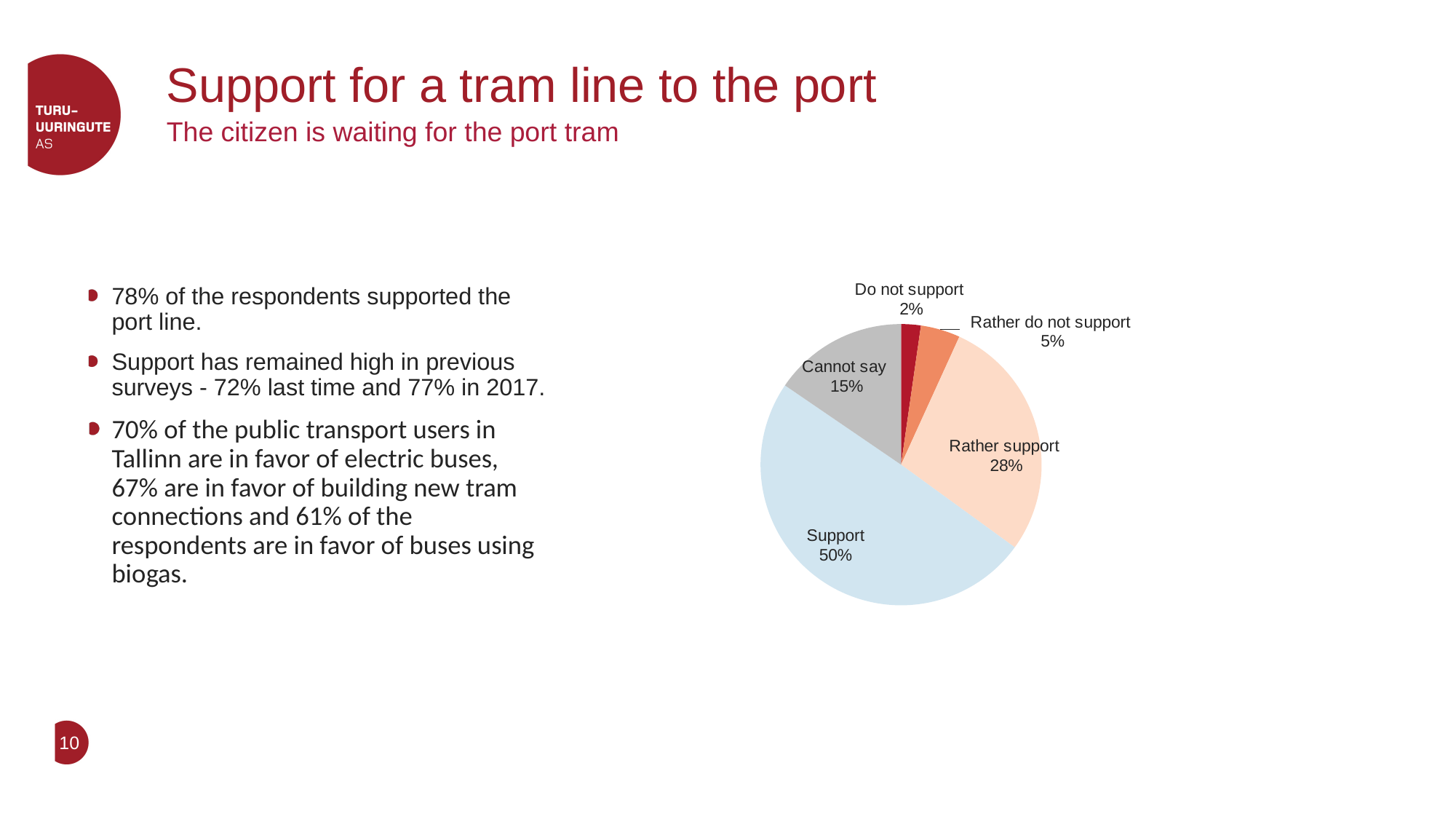
What is the value for "Rather do not support"? 5% Which category has the smallest slice of the pie? Do not support What is the value for "Rather support"? 28% What kind of chart is shown on the slide? pie chart What share of the pie does the "Support" slice represent? 50% Which category has the largest slice of the pie? Support What is the value for "Do not support"? 2% Which is larger, "Cannot say" or "Rather do not support"? Cannot say How many slices does the pie chart have? 5 What is the value for "Cannot say"? 15% What is the difference between the "Support" and "Rather support" values? 22% What is the combined share of "Support" and "Rather support"? 78%